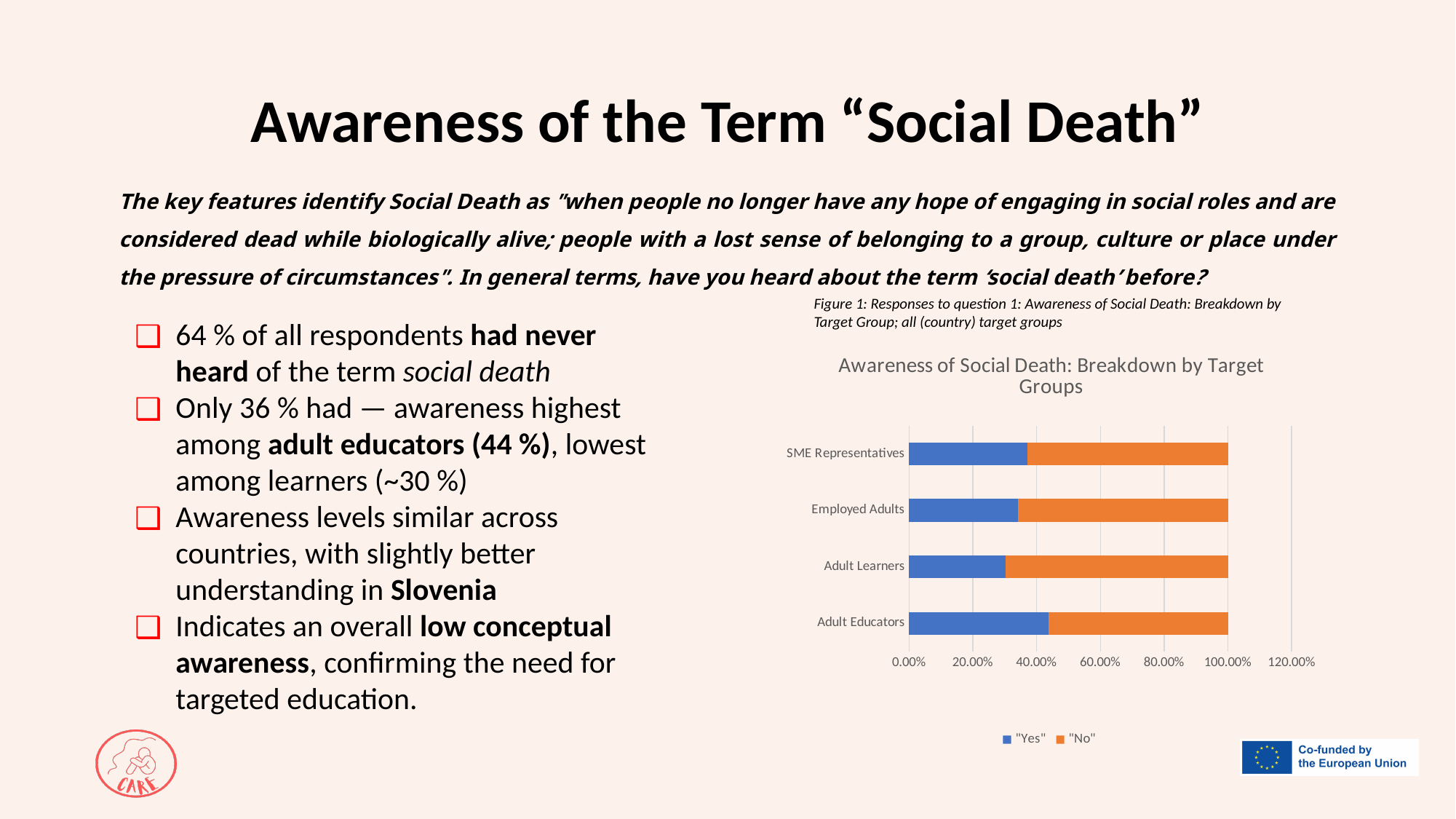
What kind of chart is shown on the slide? Bar chart How many target groups are shown on the chart? 4 Is the "Yes" share for Adult Learners greater or less than 40.00%? less Is the "Yes" share for Employed Adults greater or less than 40.00%? less Is the "Yes" share for Adult Educators greater or less than 40.00%? greater Which target group has the smallest "Yes" share? Adult Learners How many series does the chart legend list? 2 What are the two series named in the chart legend? "Yes" and "No" What is the title of the chart? Awareness of Social Death: Breakdown by Target Groups What is the total of the stacked bar for SME Representatives? 100.00% Which target group has the largest "Yes" share? Adult Educators Which is larger: the "Yes" share for Adult Educators or for Adult Learners? Adult Educators